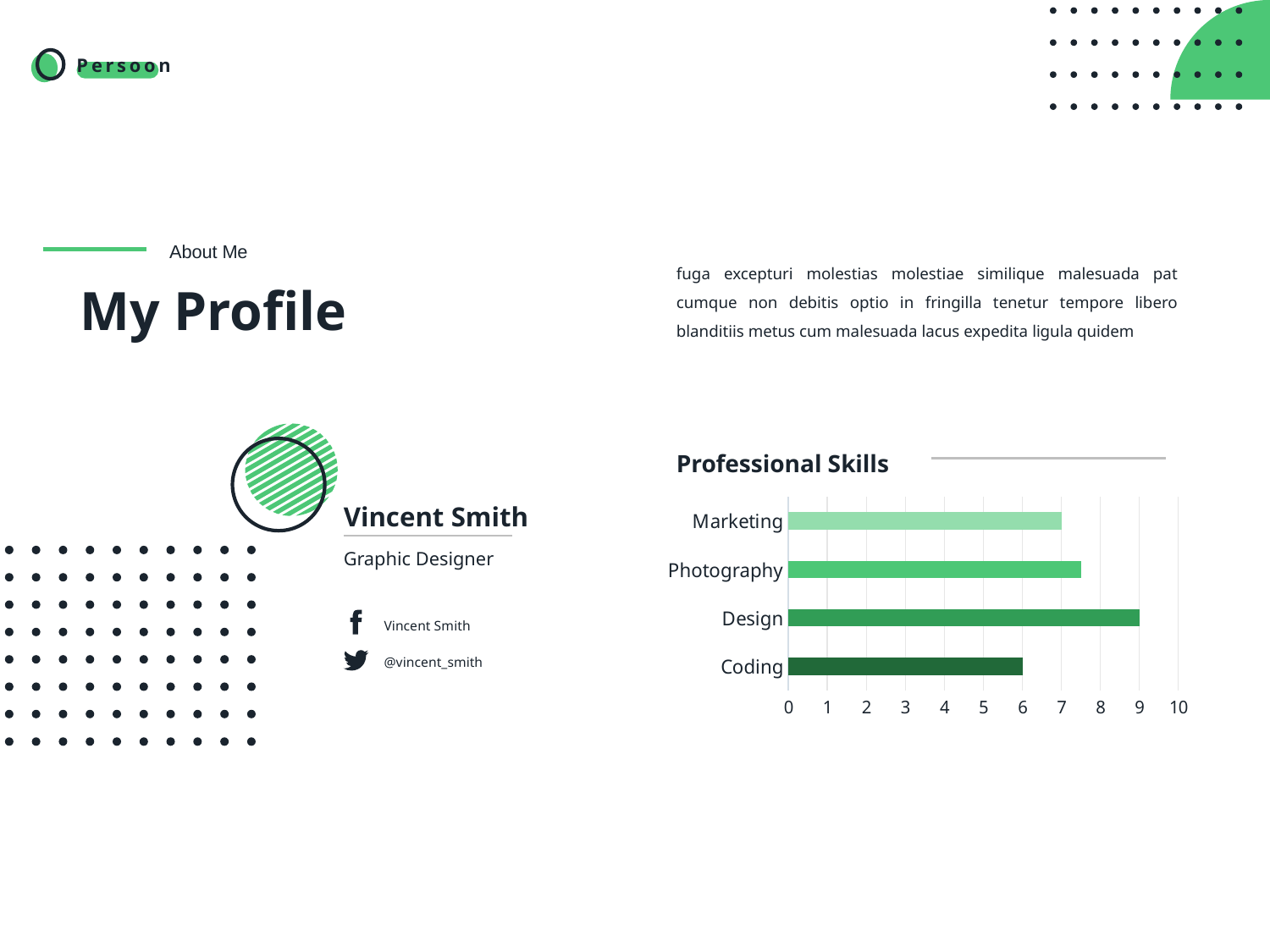
What is the value for Design in the Professional Skills chart? 9 What is the value for Coding in the Professional Skills chart? 6 What is the value for Marketing in the Professional Skills chart? 7 Is the value for Photography greater or less than 8? less What is the title of the chart on the slide? Professional Skills Is the value for Photography greater or less than 7? greater What is the difference between the Design and Coding values in the Professional Skills chart? 3 Which skill has the lowest value in the Professional Skills chart? Coding Which skill has the highest value in the Professional Skills chart? Design Which is larger in the Professional Skills chart, Design or Coding? Design What kind of chart is shown under Professional Skills? bar chart How many skill categories are plotted in the Professional Skills chart? 4